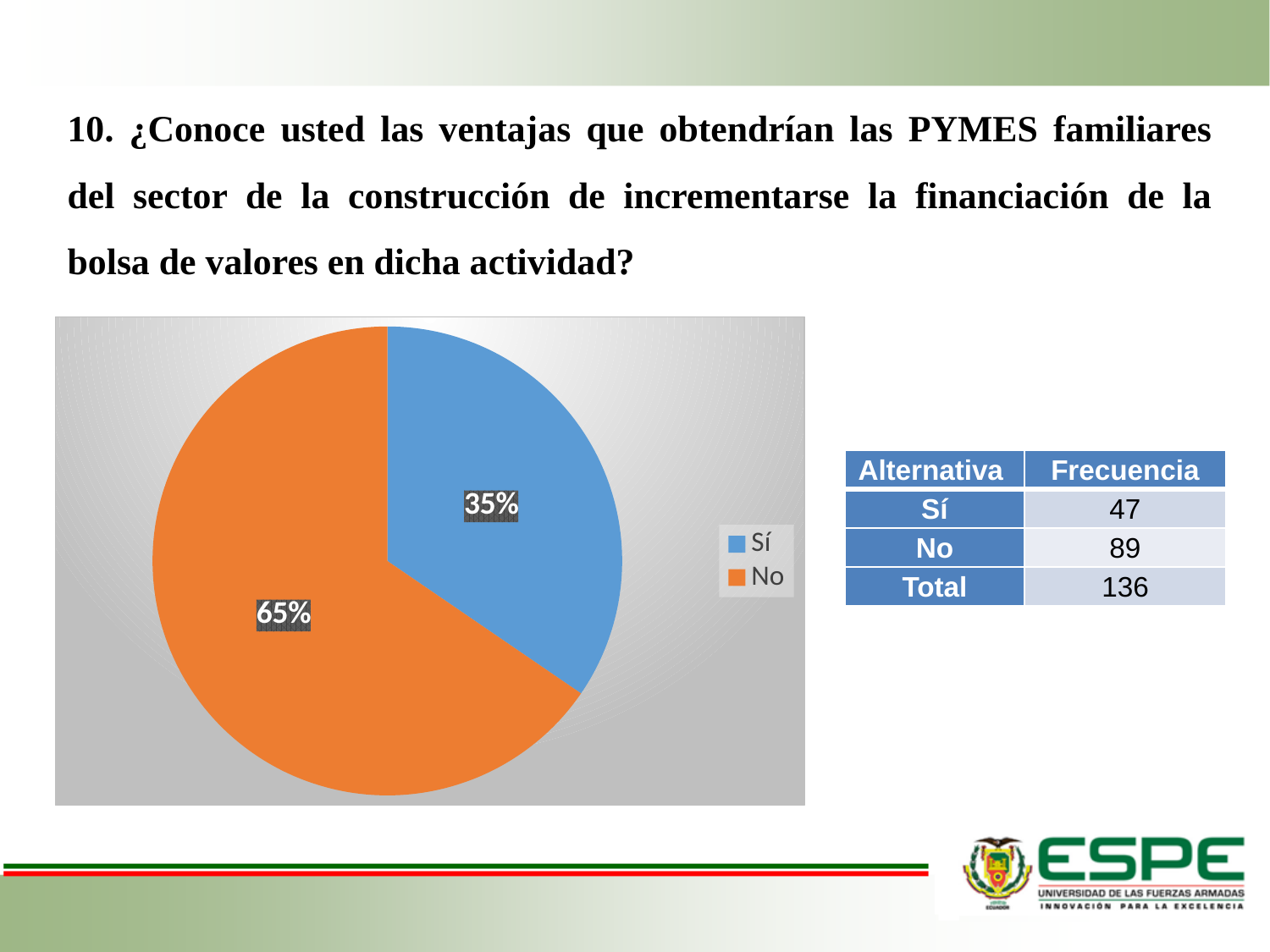
What colour is the "No" slice in the pie chart? orange How many slices does the pie chart have? 2 What percentage of the pie chart is labelled for "No"? 65% What kind of chart is shown on the slide? pie chart How many entries does the legend of the pie chart list? 2 Which slice of the pie chart is the smallest? Sí What colour is the "Sí" slice in the pie chart? blue What percentage of the pie chart is labelled for "Sí"? 35% Is the share of the "Sí" slice in the pie chart greater or less than 50%? less What is the difference in percentage points between the "No" slice and the "Sí" slice in the pie chart? 30 percentage points Which slice is larger in the pie chart, "Sí" or "No"? No Which slice of the pie chart is the largest? No